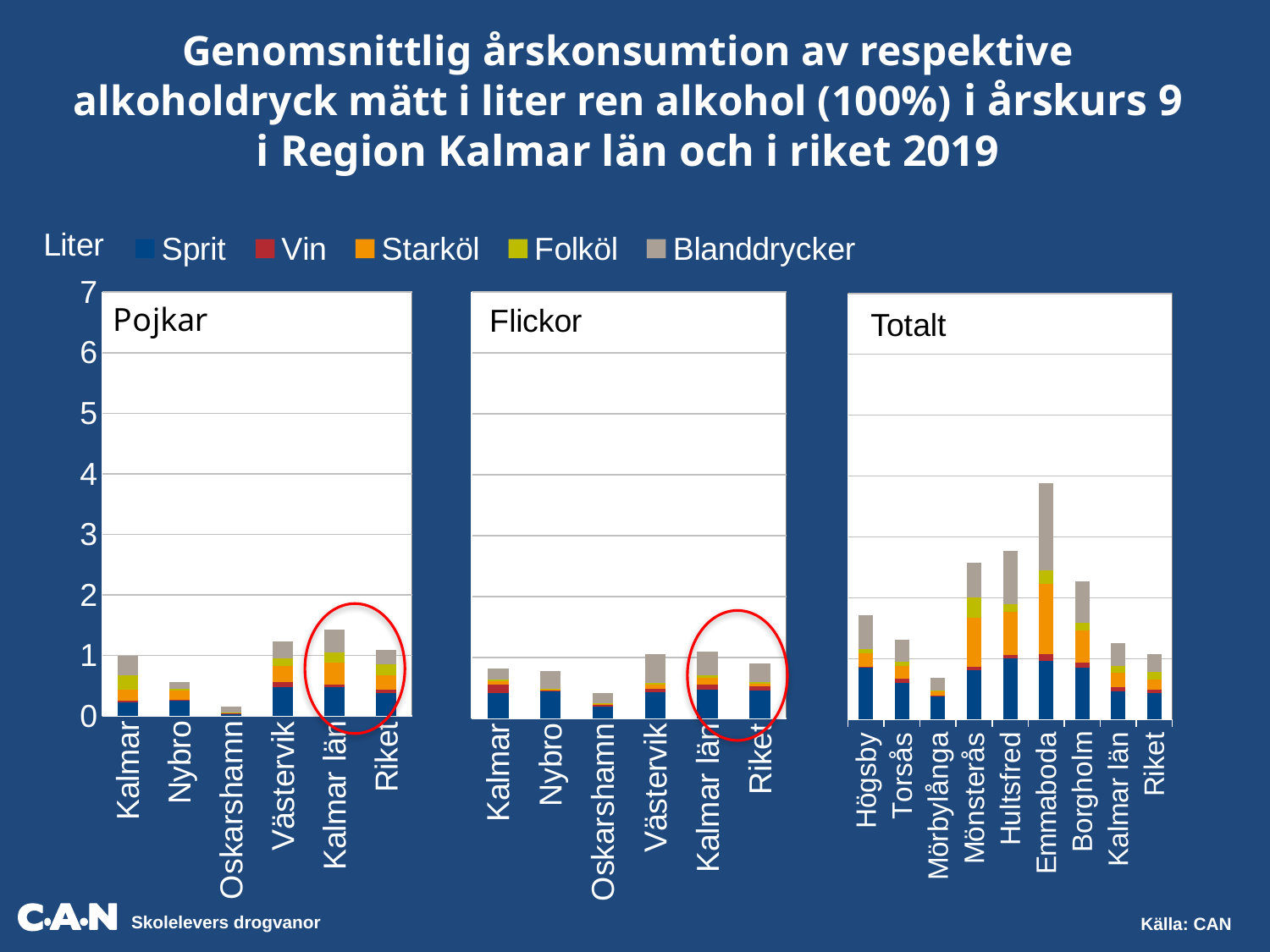
Which legend entry is shown in grey? Blanddrycker How many categories are shown on the x axis of the Flickor chart? 6 How many series does the legend list? 5 In the Totalt chart, which category has the highest total bar? Emmaboda In the Totalt chart, is the total value for Emmaboda greater or less than 3? greater In the Totalt chart, which category has the lowest total bar? Mörbylånga In the Totalt chart, is the total value for Mörbylånga greater or less than 1? less In the Pojkar chart, which has the larger total bar, Västervik or Nybro? Västervik In the Pojkar chart, which category has the lowest total bar? Oskarshamn What kind of chart is the Pojkar chart? stacked bar chart In the Pojkar chart, which category has the highest total bar? Kalmar län How many categories are shown on the x axis of the Totalt chart? 9